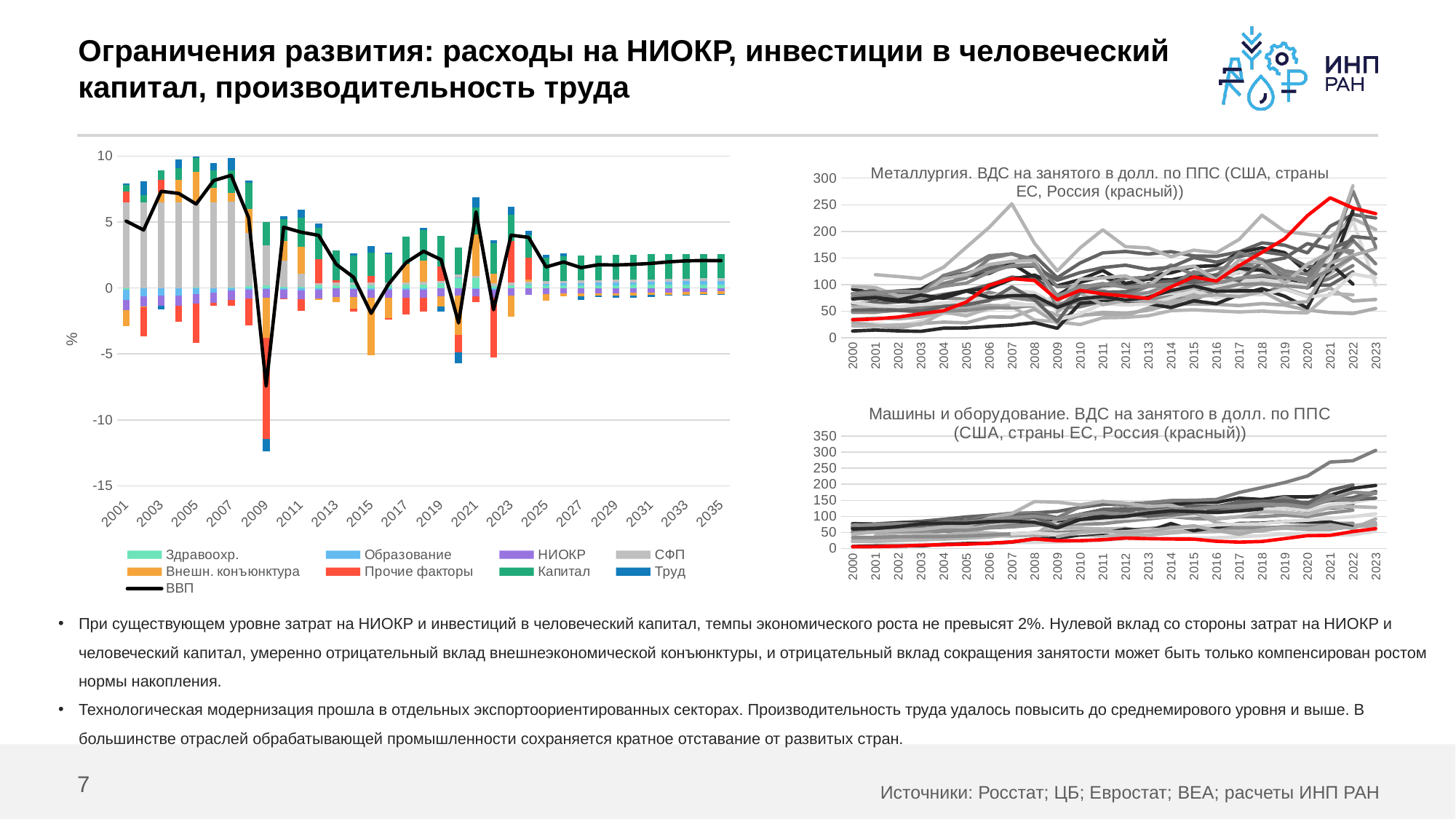
In the 'Металлургия' chart, is the value of the red Russia line in 2021 greater or less than 200? greater What kind of chart is the 'Металлургия' chart on the right? line chart In the 'Металлургия' chart, is the value of the red Russia line in 2000 greater or less than 50? less In the left chart, which series is drawn as a black line? ВВП In the left chart, is the ВВП value for 2009 greater or less than -5? less In the left chart, in which year does the ВВП line reach its lowest value? 2009 How many series does the legend of the left chart list? 9 In the 'Машины и оборудование' chart, does the red Russia line rise or fall overall from 2000 to 2023? rise What kind of chart is the left chart showing contributions to GDP growth from 2001 to 2035? stacked bar chart with a line